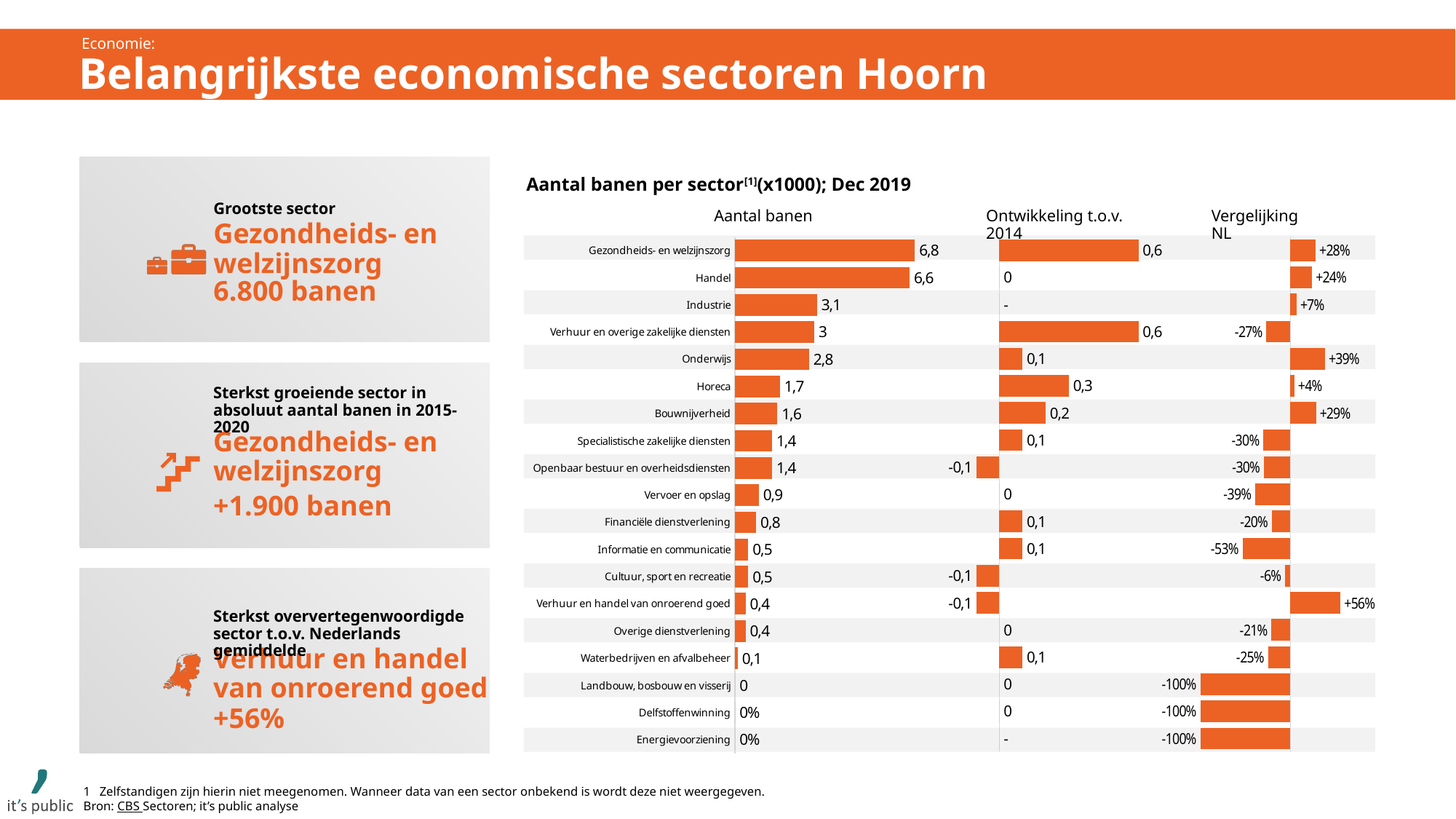
Which sector has the highest value in the 'Aantal banen' column? Gezondheids- en welzijnszorg In the 'Vergelijking NL' column, what is the value for Informatie en communicatie? -53% In the 'Aantal banen' column, which is larger: Industrie or Verhuur en overige zakelijke diensten? Industrie In the 'Vergelijking NL' column, what is the value for Onderwijs? +39% In the 'Aantal banen' column, what is the value for Handel? 6,6 In the 'Ontwikkeling t.o.v. 2014' column, what is the value for Horeca? 0,3 In the 'Aantal banen' column, what is the difference between Onderwijs and Horeca? 1,1 Which sector has the highest value in the 'Vergelijking NL' column? Verhuur en handel van onroerend goed In the 'Aantal banen' column, what is the difference between Gezondheids- en welzijnszorg and Handel? 0,2 What kind of chart is shown on the slide? Bar chart How many sectors are listed in the chart? 19 In the 'Ontwikkeling t.o.v. 2014' column, what is the value for Openbaar bestuur en overheidsdiensten? -0,1